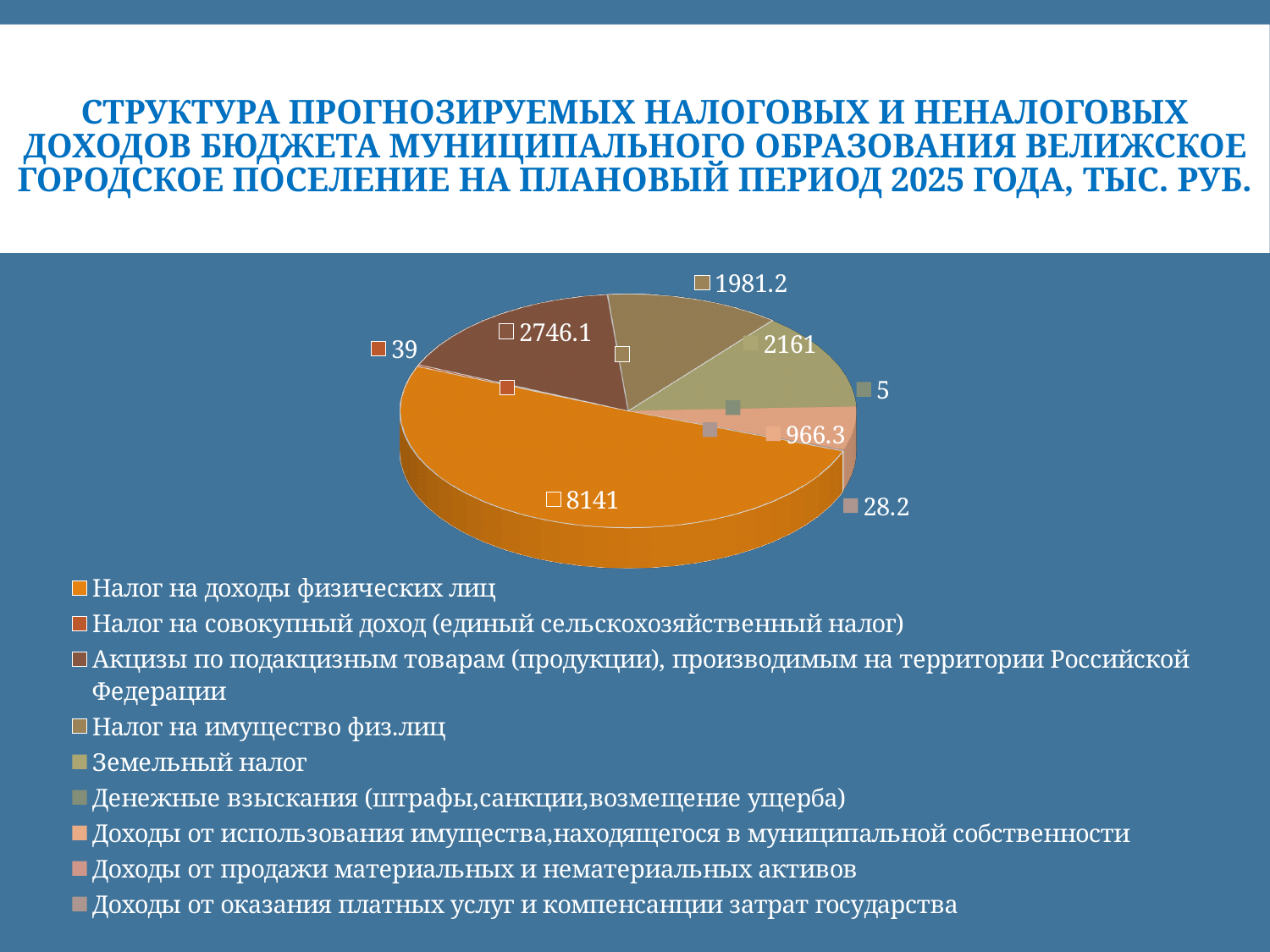
What is the difference between the values for Налог на доходы физических лиц (8141) and Акцизы по подакцизным товарам (2746.1)? 5394.9 What is the value for Налог на имущество физ.лиц? 1981.2 Which category has the largest slice of the pie? Налог на доходы физических лиц What kind of chart is shown on the slide? Pie chart What unit of measurement is stated in the chart title? тыс. руб. What is the difference between the values for Акцизы по подакцизным товарам (2746.1) and Земельный налог (2161)? 585.1 What is the value for Налог на совокупный доход (единый сельскохозяйственный налог)? 39 How many categories does the legend list? 9 What is the value for Земельный налог? 2161 Which is larger: Акцизы по подакцизным товарам or Земельный налог? Акцизы по подакцизным товарам What is the value for Налог на доходы физических лиц? 8141 What is the value for Акцизы по подакцизным товарам (продукции), производимым на территории Российской Федерации? 2746.1